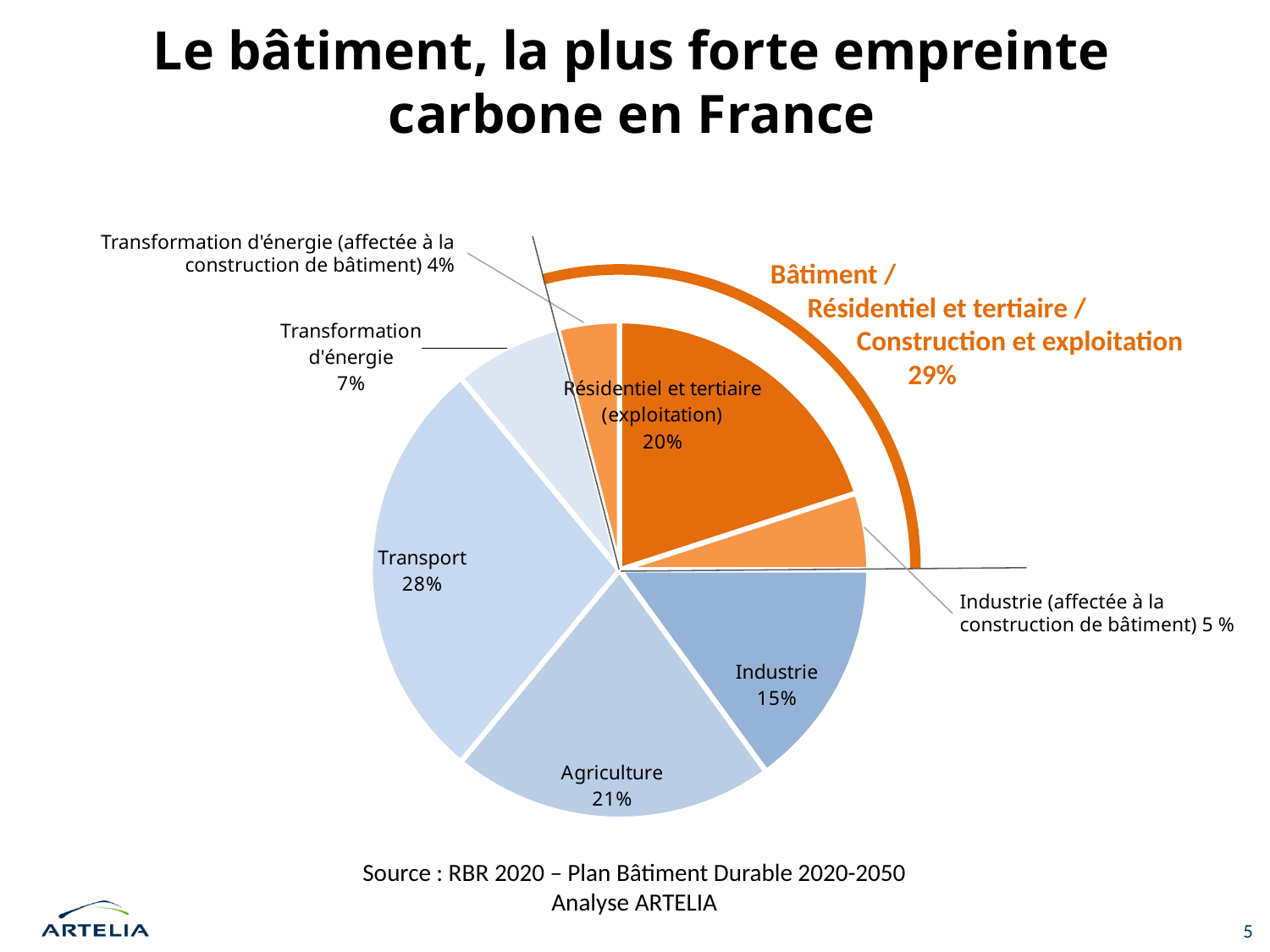
What combined percentage is shown for the Bâtiment / Résidentiel et tertiaire / Construction et exploitation grouping highlighted by the orange arc? 29% What percentage is shown for Résidentiel et tertiaire (exploitation)? 20% What is the value for Industrie (affectée à la construction de bâtiment)? 5 % What kind of chart is shown on the slide? Pie chart What is the value for Transformation d'énergie (affectée à la construction de bâtiment)? 4% Which slice of the pie is the largest? Transport How many slices does the pie chart have? 7 What share of the pie does Transport represent? 28% What is the difference between the Transport share and the Industrie share? 13% Which is larger, Agriculture or Résidentiel et tertiaire (exploitation)? Agriculture Which slice of the pie is the smallest? Transformation d'énergie (affectée à la construction de bâtiment) What is the value shown for Agriculture? 21%